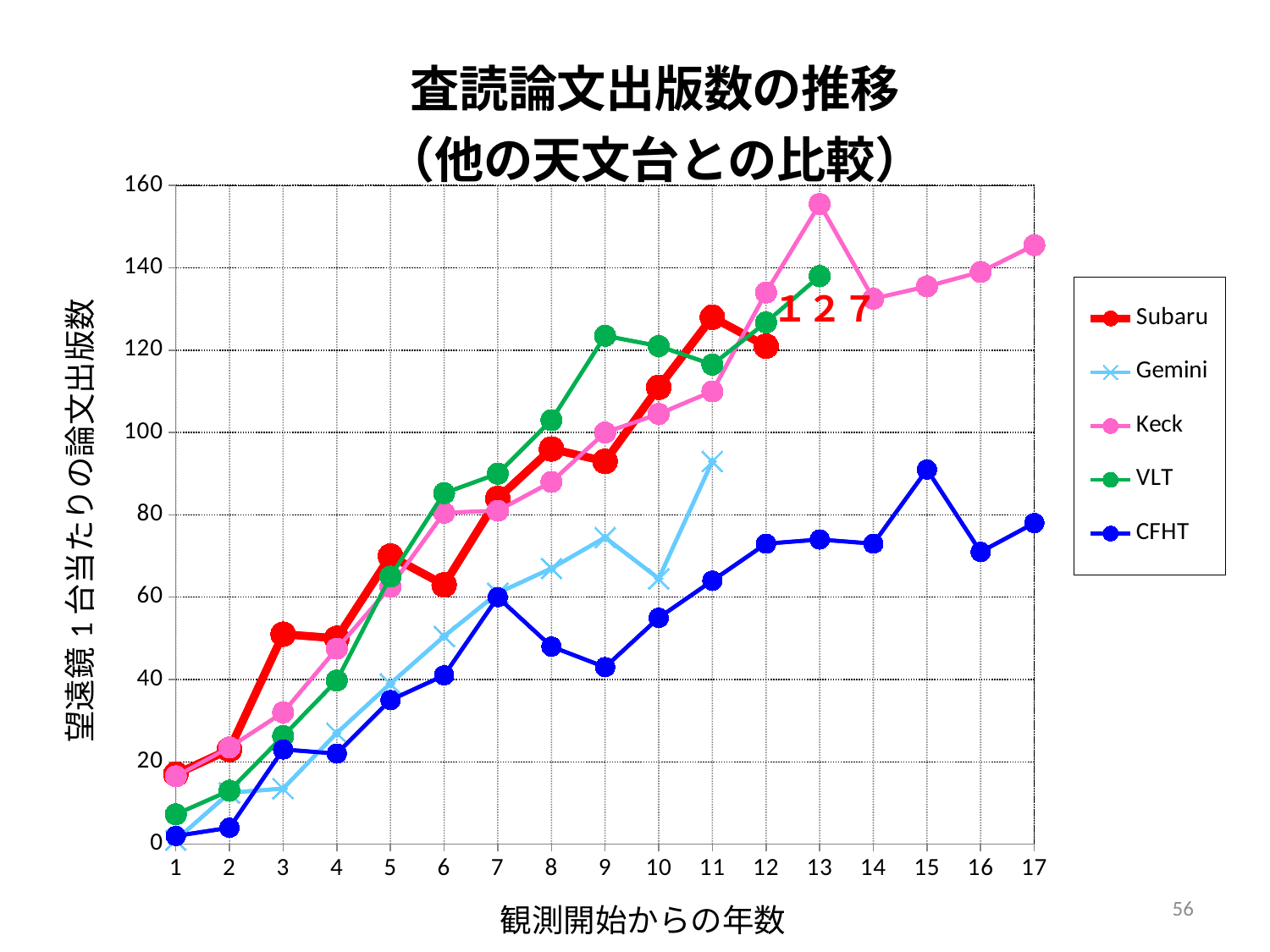
What kind of chart is shown on the slide? line chart Is the value for CFHT at year 9 greater or less than 60? less Is the value for Gemini at year 11 greater or less than 80? greater At year 9, which is higher, VLT or Subaru? VLT Which series are listed in the legend? Subaru, Gemini, Keck, VLT, CFHT Is the value for Keck at year 13 greater or less than 140? greater How many years are shown on the x axis? 17 What value is printed as a data label on the chart? 127 How many series does the legend list? 5 Which series reaches the highest value on the chart? Keck At year 3, which series has the lowest value? Gemini